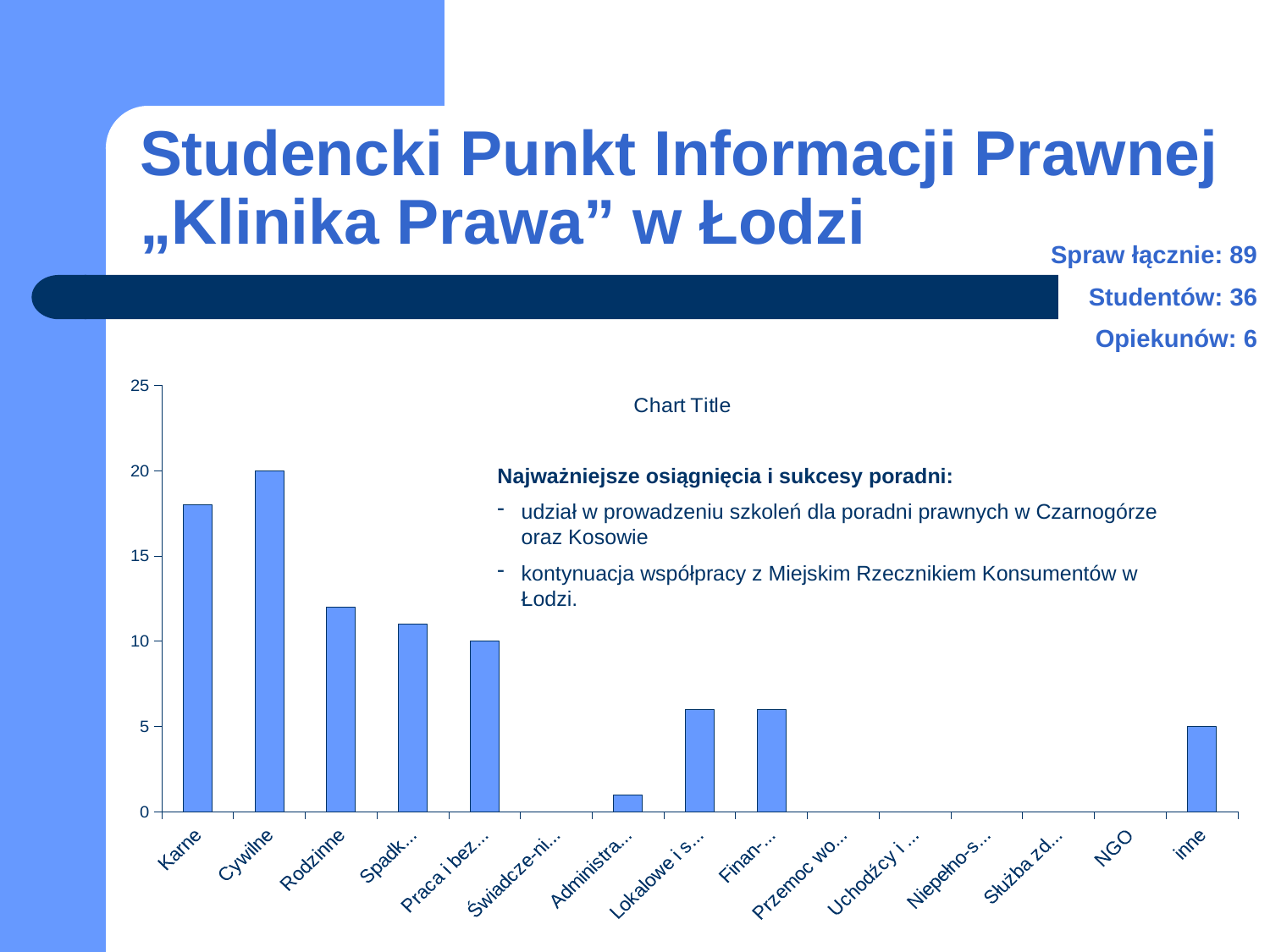
What is the value for inne? 5 Which category has the highest value? Cywilne How many categories are shown on the x axis? 15 Is the value for Rodzinne greater or less than 10? greater Is the value for the category labelled "Administra..." greater or less than 5? less What is the difference between the values for Cywilne and inne? 15 What is the value for the category labelled "Praca i bez..."? 10 Which is larger, the value for Karne or the value for Rodzinne? Karne What is the value for Cywilne? 20 Is the value for Karne greater or less than 15? greater What is the title shown on the chart? Chart Title What type of chart is shown on the slide? bar chart